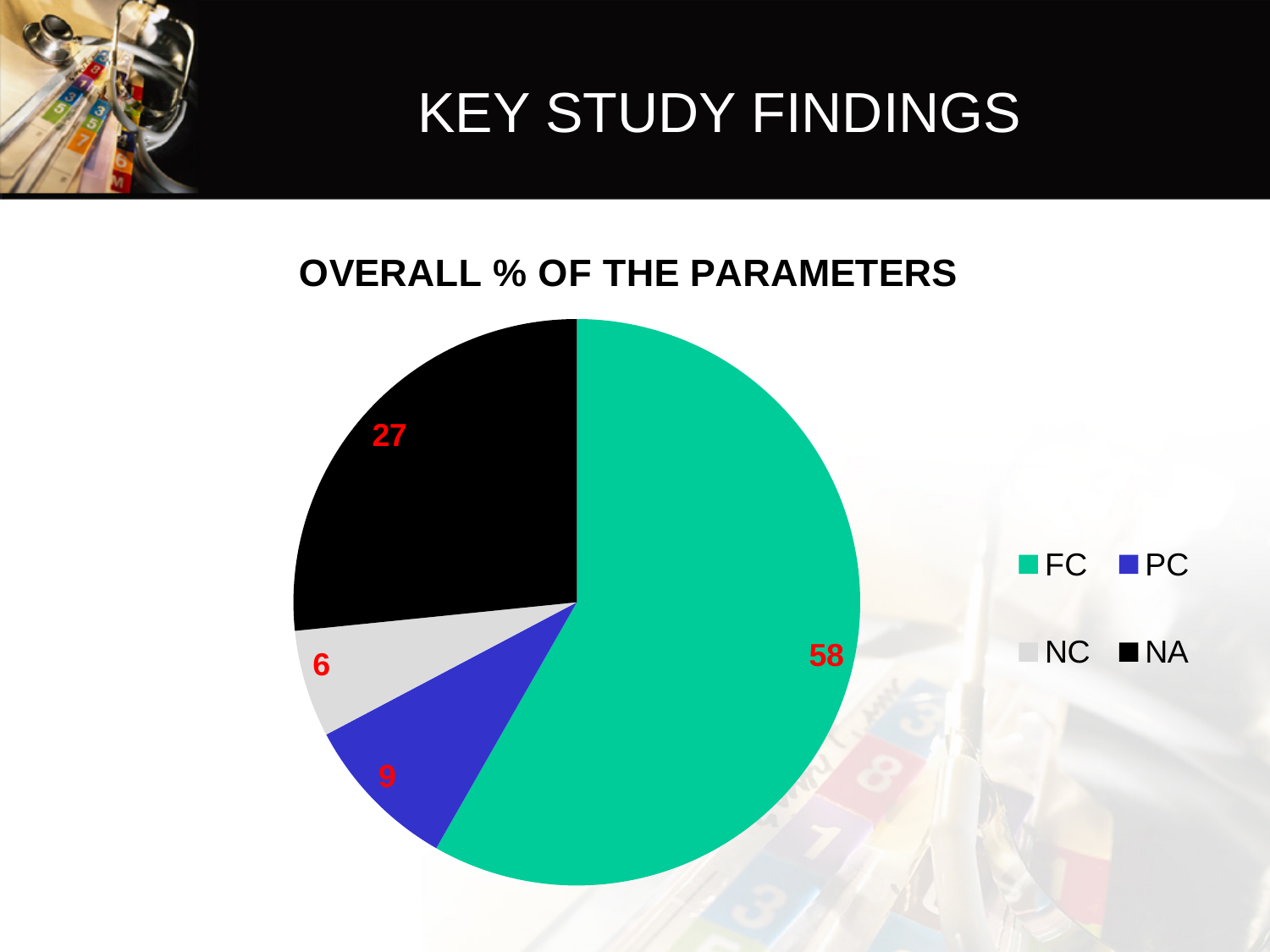
Which is larger, PC or NC? PC What colour is the FC slice? green What is the value for PC? 9 What is the chart's title? OVERALL % OF THE PARAMETERS What is the difference between the values for FC and NA? 31 What is the value for NA? 27 Which category has the largest slice? FC Which category has the smallest slice? NC What is the value for FC? 58 What kind of chart is shown on the slide? pie chart What is the value for NC? 6 How many categories does the legend list? 4